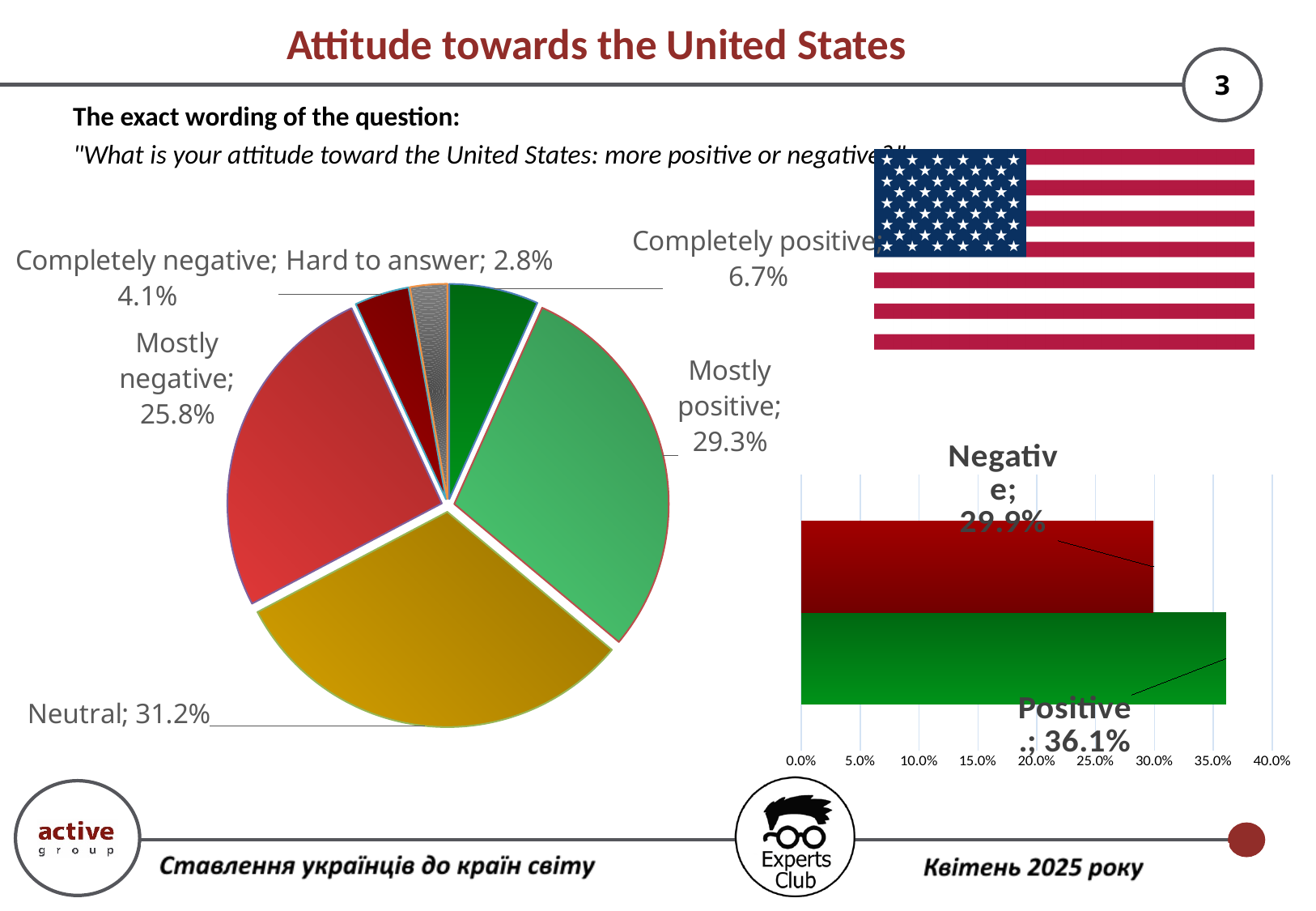
In the bar chart on the right, what is the difference between Positive and Negative? 6.2% In the pie chart, what is the value for Completely negative? 4.1% In the bar chart on the right, what is the value for Positive? 36.1% In the pie chart, what is the difference between Mostly positive and Mostly negative? 3.5% In the pie chart, what is the value for Mostly positive? 29.3% In the pie chart, what is the value for Hard to answer? 2.8% In the pie chart, what share is labelled Neutral? 31.2% In the pie chart, which category has the smallest share? Hard to answer What type of chart is shown on the right side of the slide? Bar chart In the pie chart, which is larger: Completely positive or Completely negative? Completely positive How many categories does the pie chart show? 6 In the pie chart, which category has the largest share? Neutral